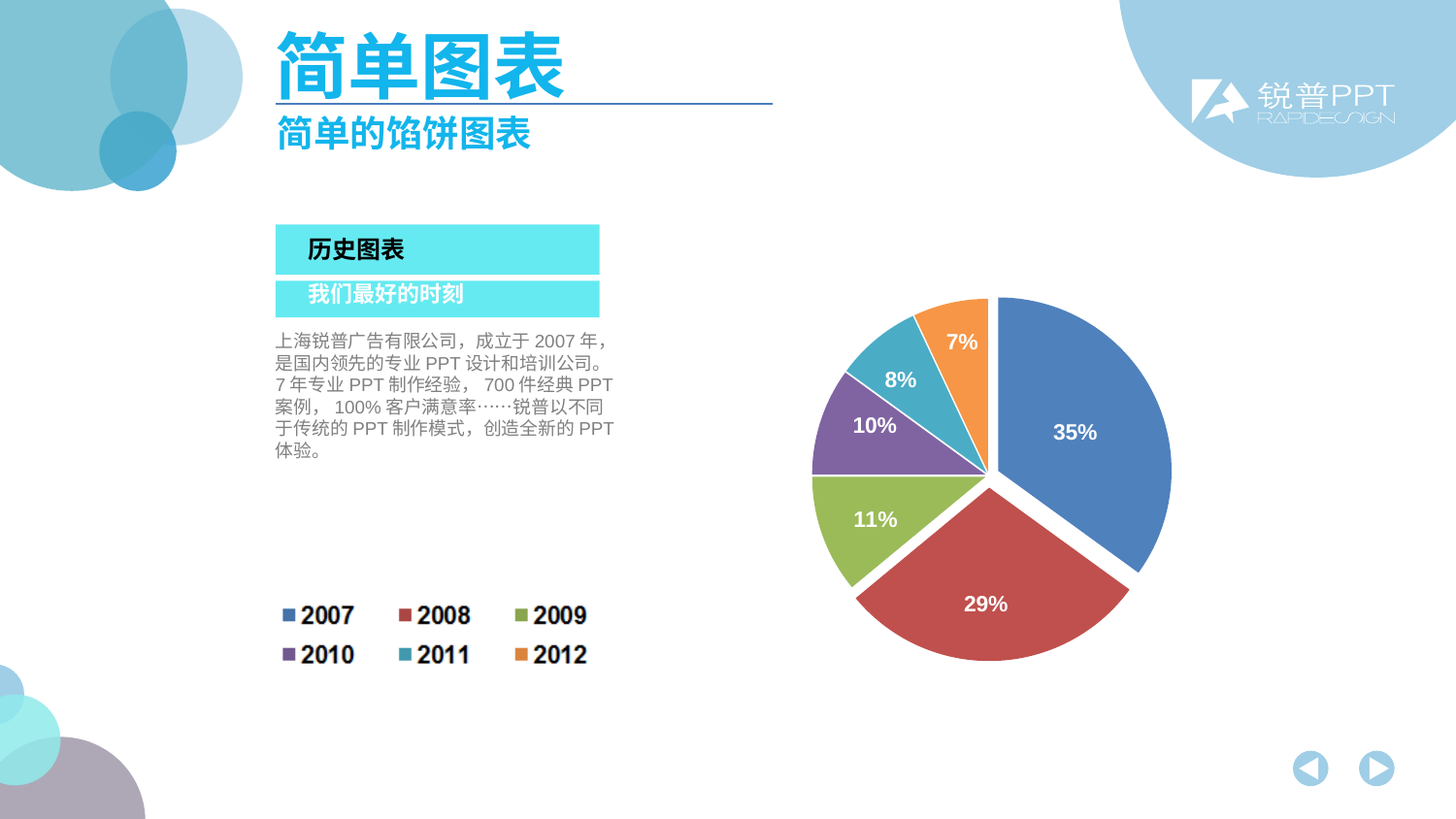
What is the value shown for 2009? 11% What is the value shown for 2011? 8% How many slices does the pie chart have? 6 Which is larger, the share for 2010 or the share for 2011? 2010 What share of the pie does 2008 have? 29% What share of the pie does 2007 have? 35% Which year has the largest slice of the pie? 2007 What kind of chart is shown on the slide? pie chart What is the value shown for 2012? 7% How many entries does the legend list? 6 What is the difference between the shares for 2007 and 2008? 6% Which year has the smallest slice of the pie? 2012